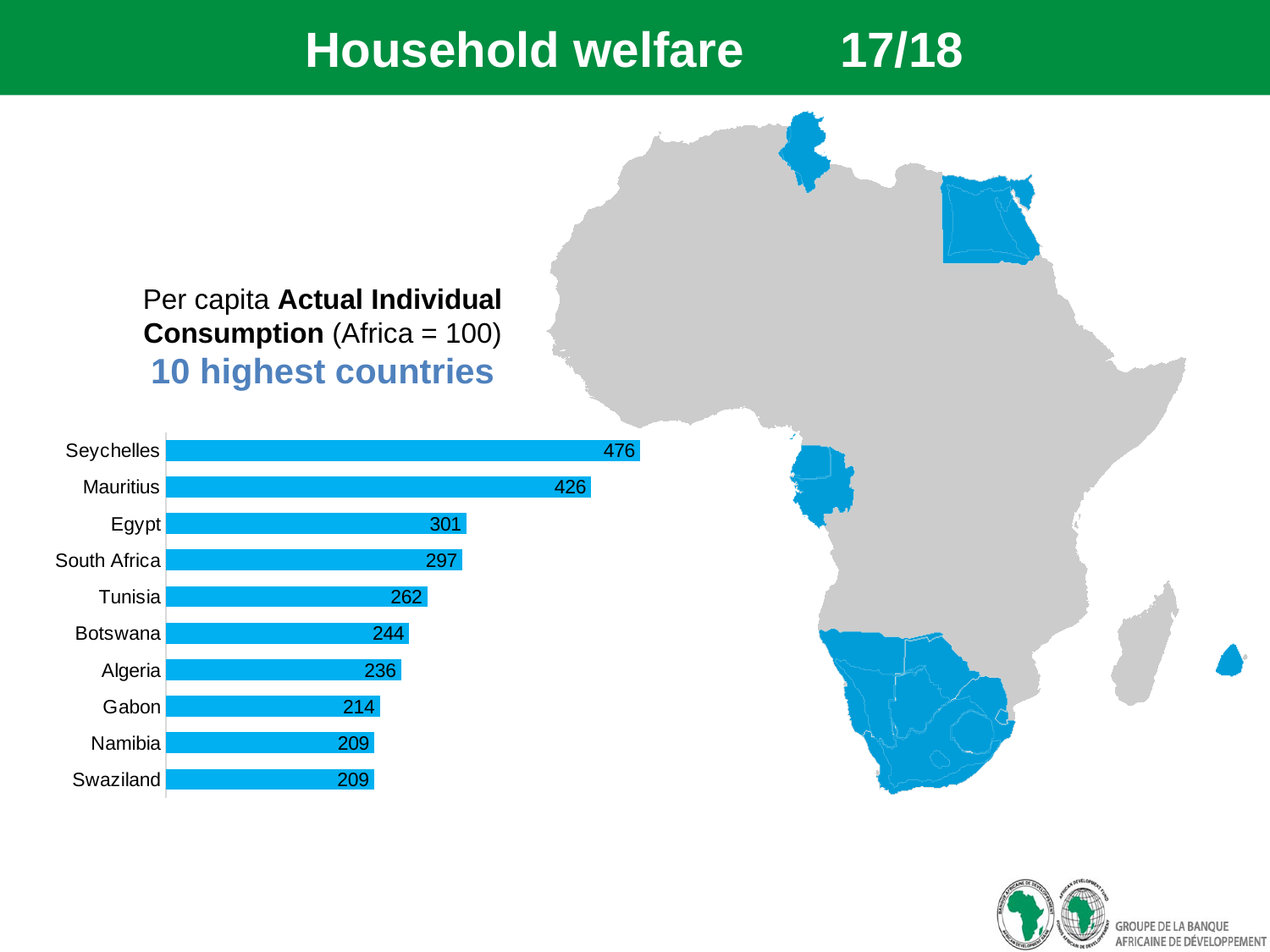
What is the value shown for Botswana? 244 What is the difference between the values for Seychelles and Mauritius? 50 What kind of chart is used to show the 10 highest countries? Bar chart What is the per capita Actual Individual Consumption value for Seychelles? 476 Which has a larger value, Tunisia or Algeria? Tunisia What is the value shown for Gabon? 214 Which has a larger value, Gabon or Botswana? Botswana How many countries are shown in the bar chart? 10 Which country has the highest per capita Actual Individual Consumption on the chart? Seychelles What is the value shown for Egypt? 301 Which two countries share the same value of 209? Namibia and Swaziland What is the difference between the values for Egypt and South Africa? 4